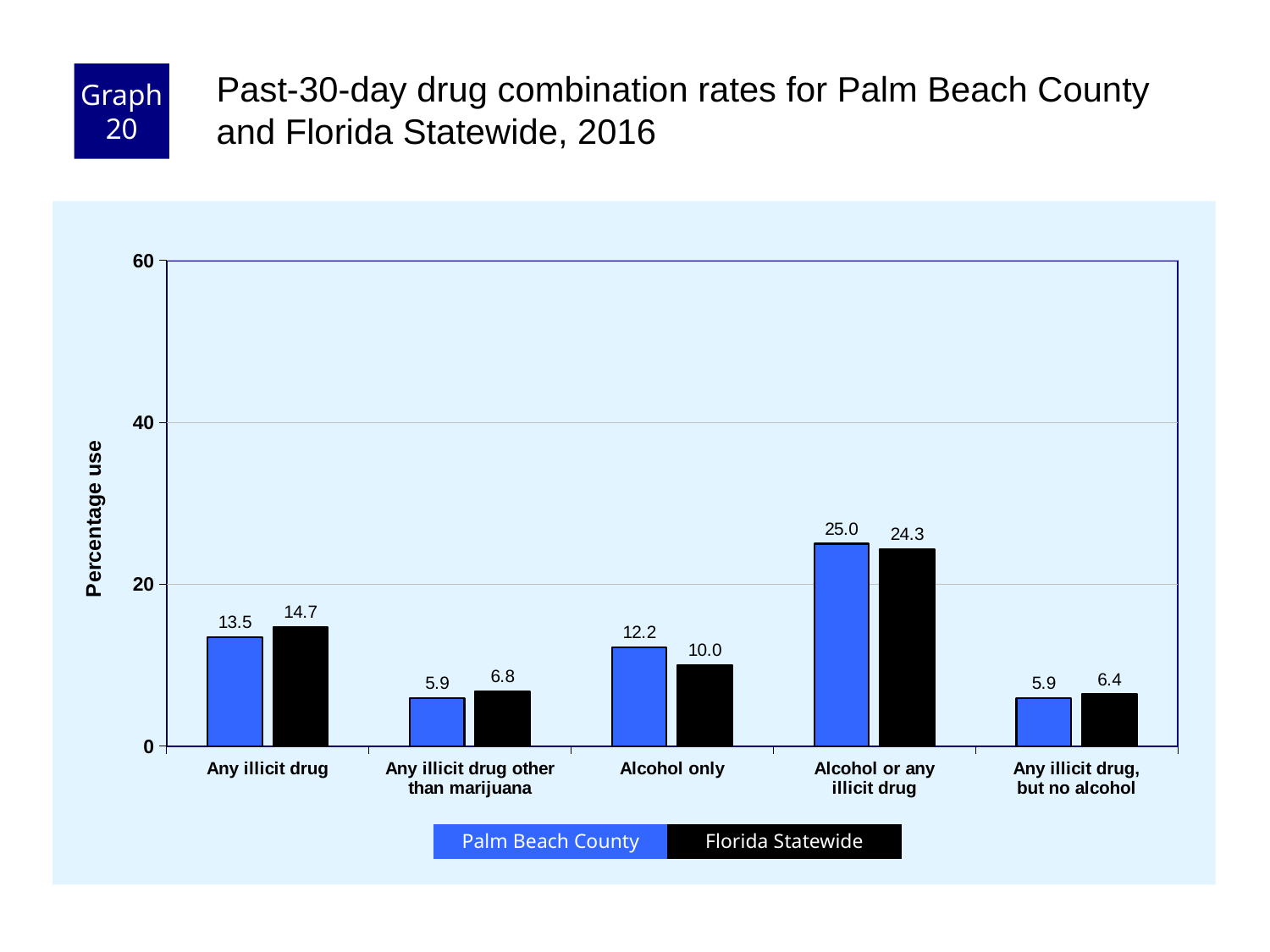
Which category has the lowest Florida Statewide value? Any illicit drug, but no alcohol Is the Florida Statewide value for Alcohol or any illicit drug greater or less than 20? greater What is the Florida Statewide value for Any illicit drug? 14.7 What is the difference between the Palm Beach County and Florida Statewide values for Alcohol only? 2.2 How many categories are shown on the x axis? 5 For Alcohol or any illicit drug, which is larger: Palm Beach County or Florida Statewide? Palm Beach County What is the Florida Statewide value for Any illicit drug, but no alcohol? 6.4 Which category has the highest Palm Beach County value? Alcohol or any illicit drug What is the difference between the Florida Statewide and Palm Beach County values for Any illicit drug other than marijuana? 0.9 What type of chart is shown on the slide? Bar chart What is the Palm Beach County value for Alcohol only? 12.2 How many series does the legend list? 2